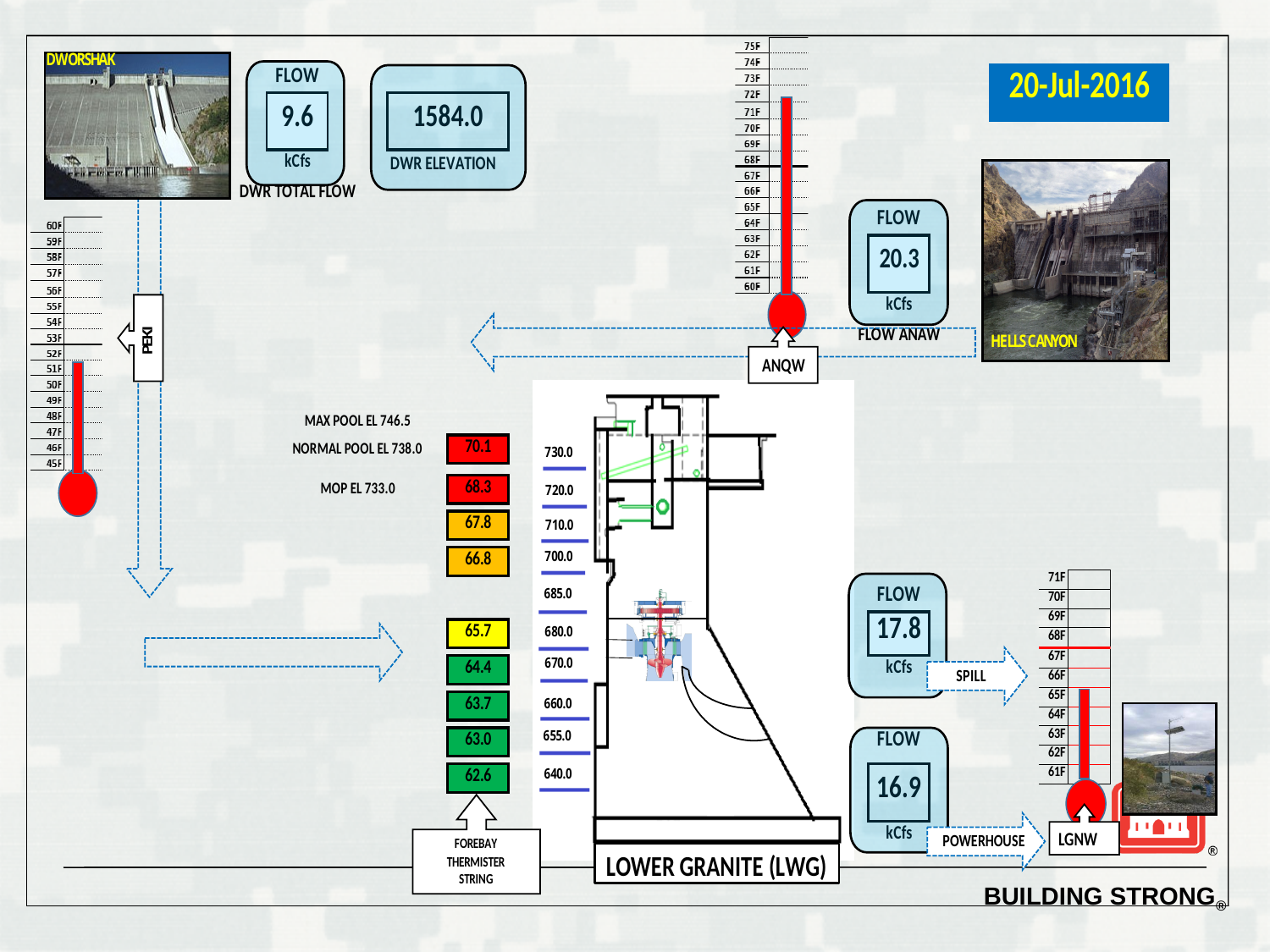
What date is shown on the slide? 20-Jul-2016 What is the flow shown for Hells Canyon (FLOW ANAW)? 20.3 kCfs What is the powerhouse flow shown for Lower Granite? 16.9 kCfs How many temperature readings are shown on the forebay thermister string? 9 What is the lowest temperature reading on the forebay thermister string? 62.6 What is the difference between the spill flow and the powerhouse flow at Lower Granite? 0.9 kCfs What is the DWR total flow shown for Dworshak? 9.6 kCfs What is the highest temperature reading on the forebay thermister string? 70.1 Which is larger at Lower Granite, the spill flow or the powerhouse flow? Spill flow What is the spill flow shown for Lower Granite? 17.8 kCfs What is the DWR elevation shown for Dworshak? 1584.0 Do the forebay thermister string readings increase or decrease from top to bottom? Decrease